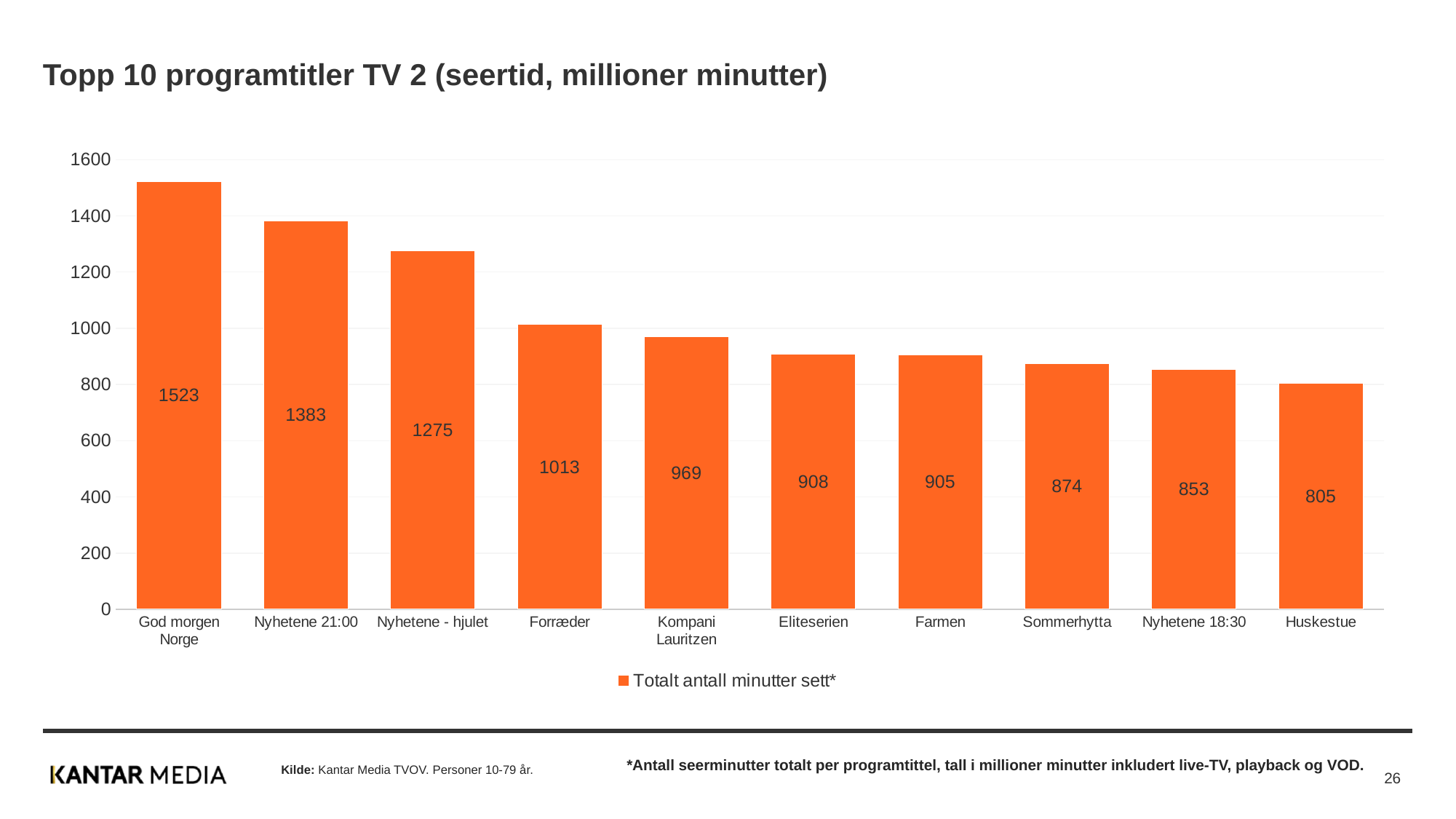
Which program title has the lowest value? Huskestue Is the value for Nyhetene 18:30 greater or less than 1000? less What is the difference between the values for Nyhetene 21:00 and Nyhetene - hjulet? 108 What is the legend entry for the series shown in the chart? Totalt antall minutter sett* Which is larger, the value for Kompani Lauritzen or the value for Farmen? Kompani Lauritzen Which program title has the highest value? God morgen Norge What is the value for Forræder? 1013 How many program titles are shown in the chart? 10 What is the value for God morgen Norge? 1523 What is the value for Sommerhytta? 874 What kind of chart is shown on the slide? bar chart What is the difference between the values for God morgen Norge and Huskestue? 718